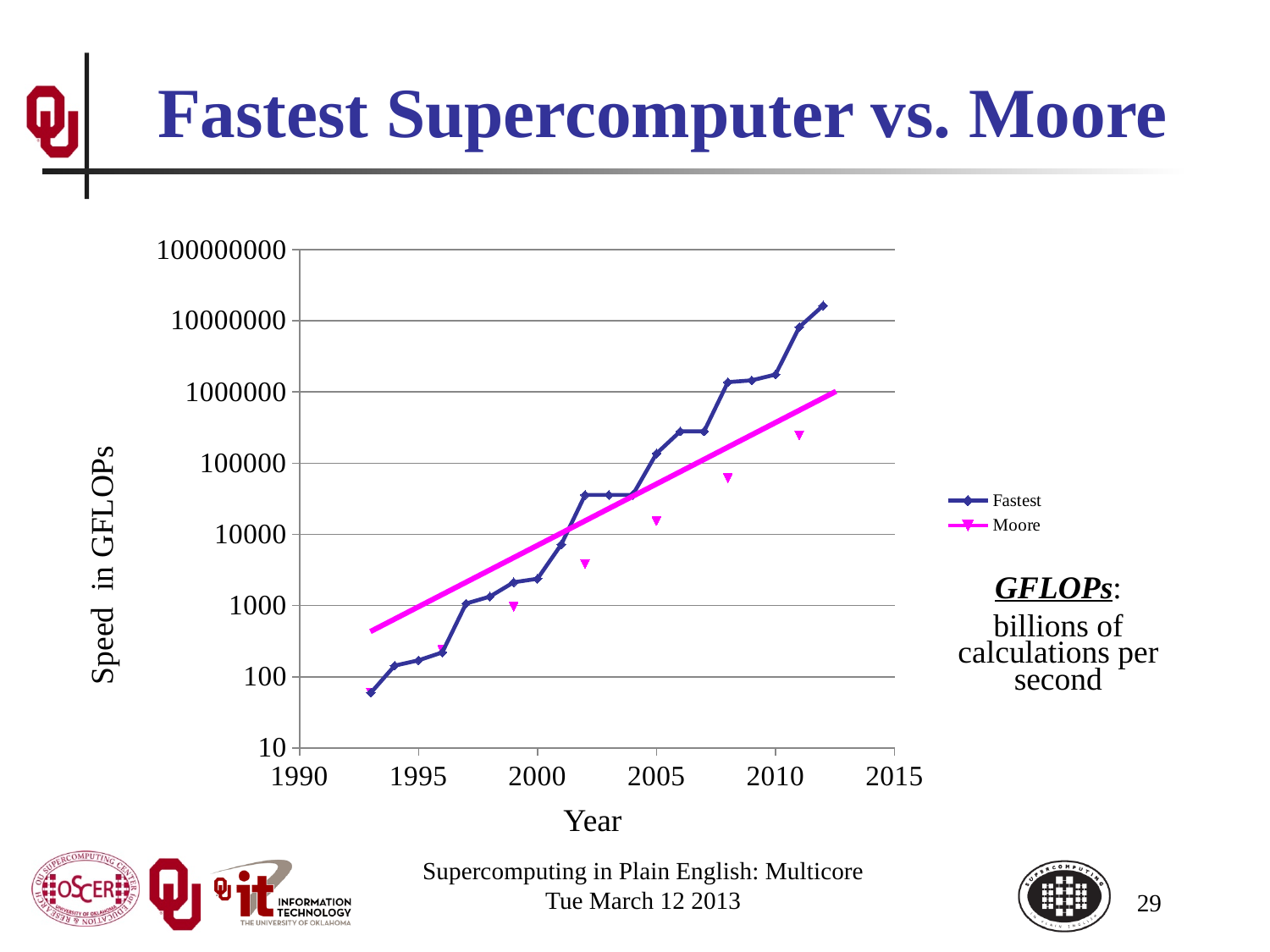
In 2011, which series has the larger value, Fastest or Moore? Fastest What kind of chart is shown on the slide? line chart Is the value of the Fastest series in 2012 greater or less than 10000000? greater What is the title of the chart on the slide? Fastest Supercomputer vs. Moore In which year does the Fastest series have its lowest value? 1993 In which year does the Fastest series reach its highest value? 2012 Is the value of the Fastest series in 1993 greater or less than 100? less What are the two series named in the legend? Fastest and Moore Is the value of the Moore series in 2002 greater or less than 10000? less How many series does the legend list? 2 Does the Fastest series rise or fall as the year increases? rise